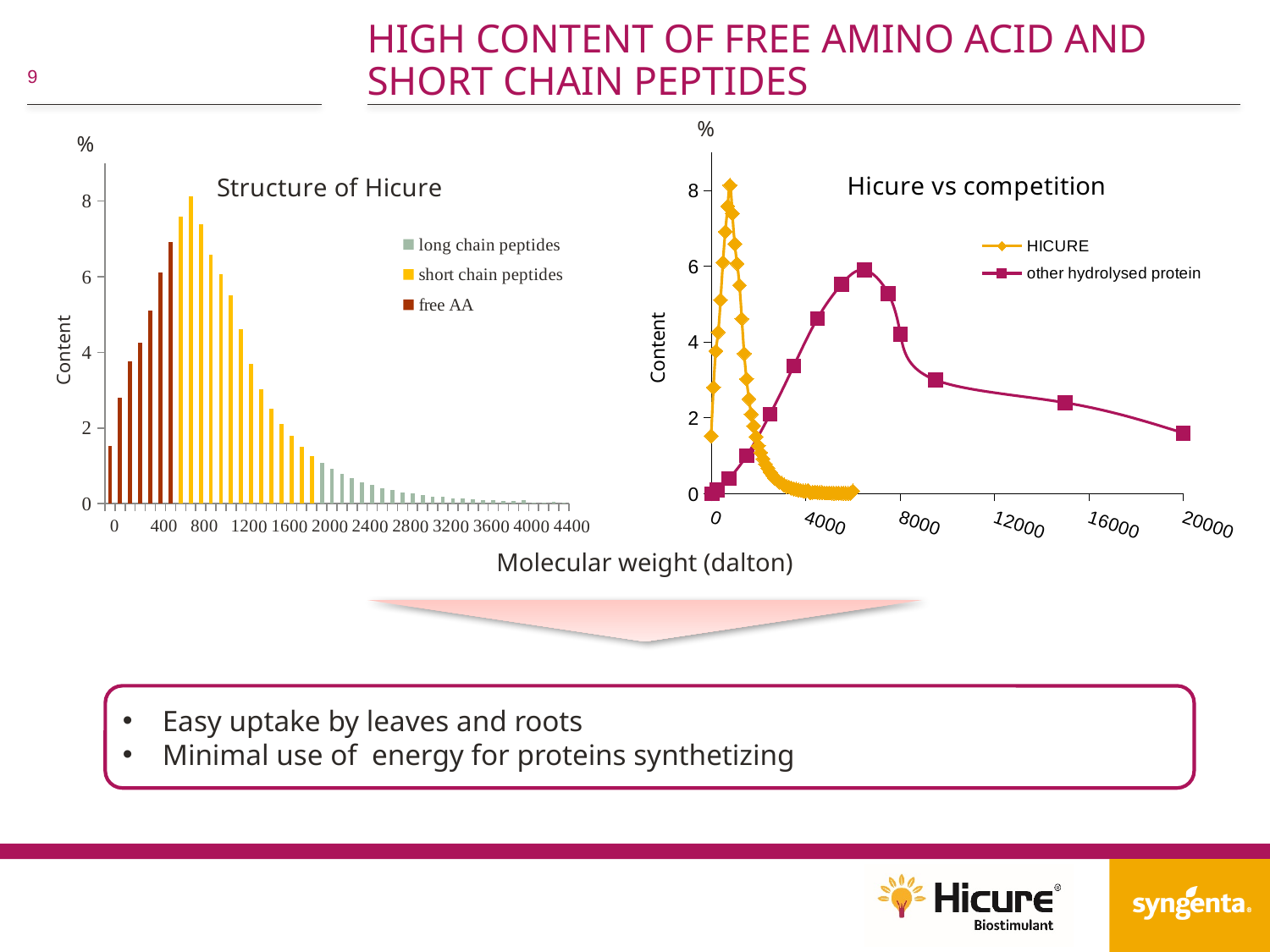
In the 'Structure of Hicure' chart, which series contains the tallest bar? short chain peptides How many series does the legend of the 'Structure of Hicure' chart list? 3 What kind of chart is the 'Structure of Hicure' chart? bar chart In the 'Structure of Hicure' chart, are the long chain peptides bars greater or less than 2? less In the 'Structure of Hicure' chart, do the bar heights rise or fall as molecular weight increases from 1200 to 4400? fall In the 'Hicure vs competition' chart, does the other hydrolysed protein line rise or fall between 8000 and 20000 dalton? fall In the 'Hicure vs competition' chart, which series reaches the higher peak, HICURE or other hydrolysed protein? HICURE What is the shared x-axis label beneath the two charts? Molecular weight (dalton) What kind of chart is the 'Hicure vs competition' chart? line chart In the 'Hicure vs competition' chart, is the peak value of other hydrolysed protein greater or less than 8? less In the 'Structure of Hicure' chart, is the tallest short chain peptides bar greater or less than 6? greater How many series does the legend of the 'Hicure vs competition' chart list? 2